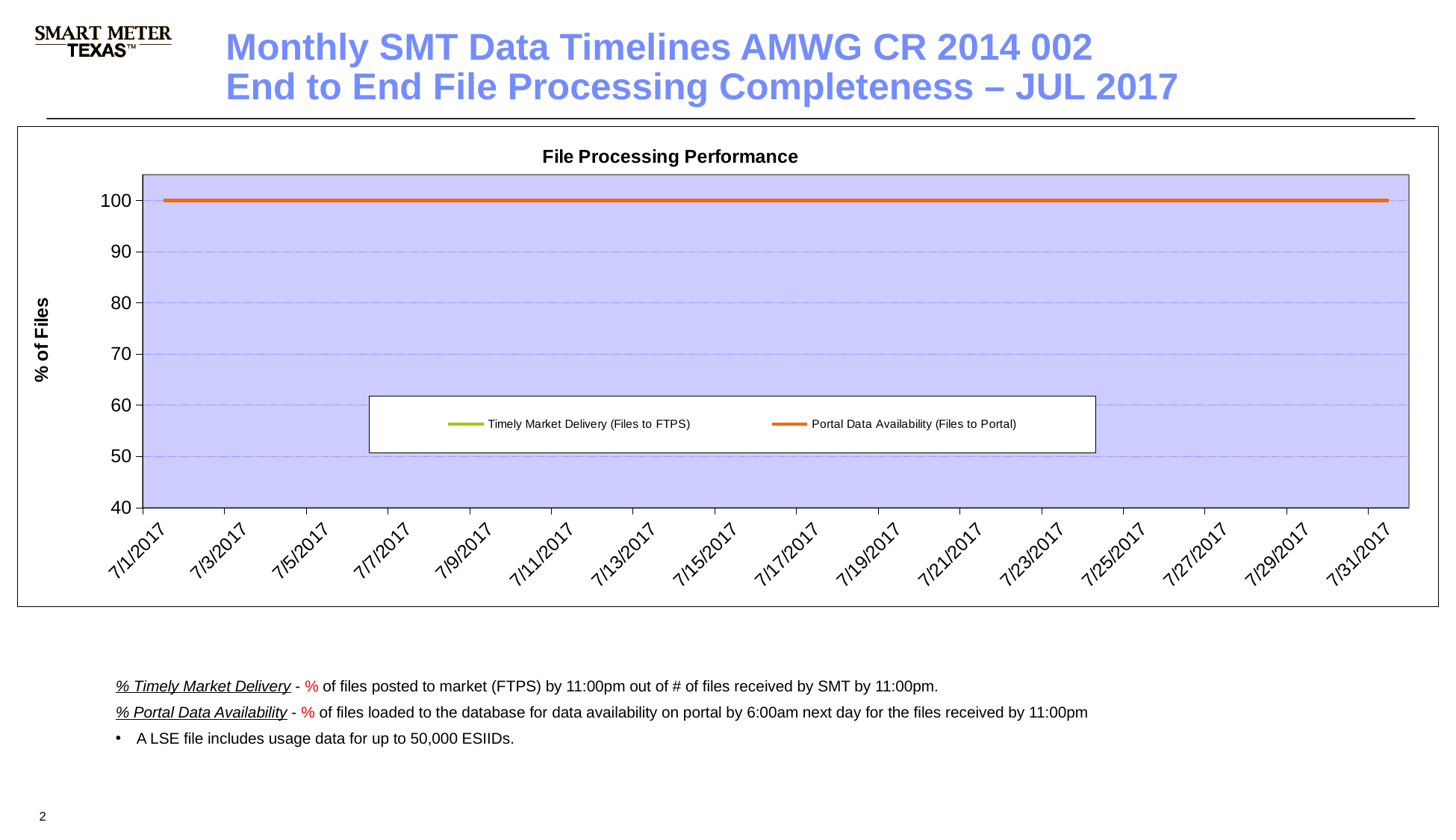
Do the values of Portal Data Availability (Files to Portal) rise, fall, or stay flat across July 2017? stay flat Is the value for Portal Data Availability (Files to Portal) on 7/9/2017 greater or less than 90? greater What is the label of the y axis? % of Files What is the difference between the Portal Data Availability (Files to Portal) values on 7/1/2017 and 7/31/2017? 0 What is the value of Portal Data Availability (Files to Portal) on 7/1/2017? 100 What kind of chart is shown on the slide? line chart What is the lowest value shown on the y axis? 40 What is the title of the chart? File Processing Performance What is the value of Portal Data Availability (Files to Portal) on 7/15/2017? 100 What is the value of Portal Data Availability (Files to Portal) on 7/31/2017? 100 How many series does the chart legend list? 2